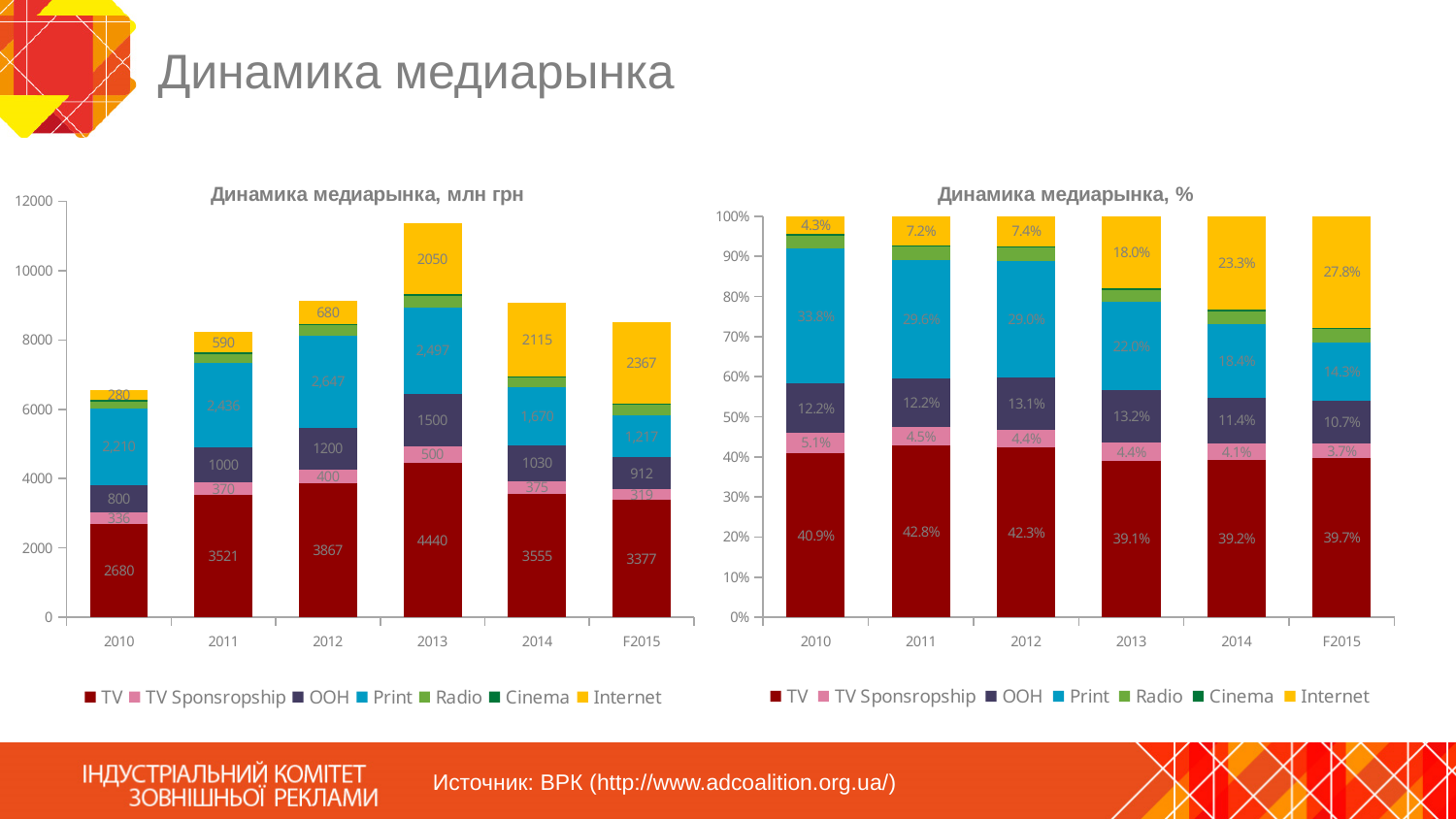
In the chart 'Динамика медиарынка, %', what is the Internet share for 2014? 23.3% In the chart 'Динамика медиарынка, млн грн', what is the TV value for 2013? 4440 In the chart 'Динамика медиарынка, млн грн', is the total height of the 2013 bar greater or less than 10000? greater In the chart 'Динамика медиарынка, млн грн', what is the Internet value for F2015? 2367 In the chart 'Динамика медиарынка, млн грн', which year has the highest TV value? 2013 What kind of chart is 'Динамика медиарынка, %'? stacked bar chart In the chart 'Динамика медиарынка, %', does the Internet share rise or fall from 2010 to F2015? rises In the chart 'Динамика медиарынка, %', what is the Print share for 2010? 33.8% How many series does the legend of the chart 'Динамика медиарынка, млн грн' list? 7 In the chart 'Динамика медиарынка, млн грн', which year has the lowest Internet value? 2010 In the chart 'Динамика медиарынка, млн грн', what is the difference between the Internet values for 2013 and 2012? 1370 In the chart 'Динамика медиарынка, %', which is larger, the TV share in 2011 or in 2013? 2011